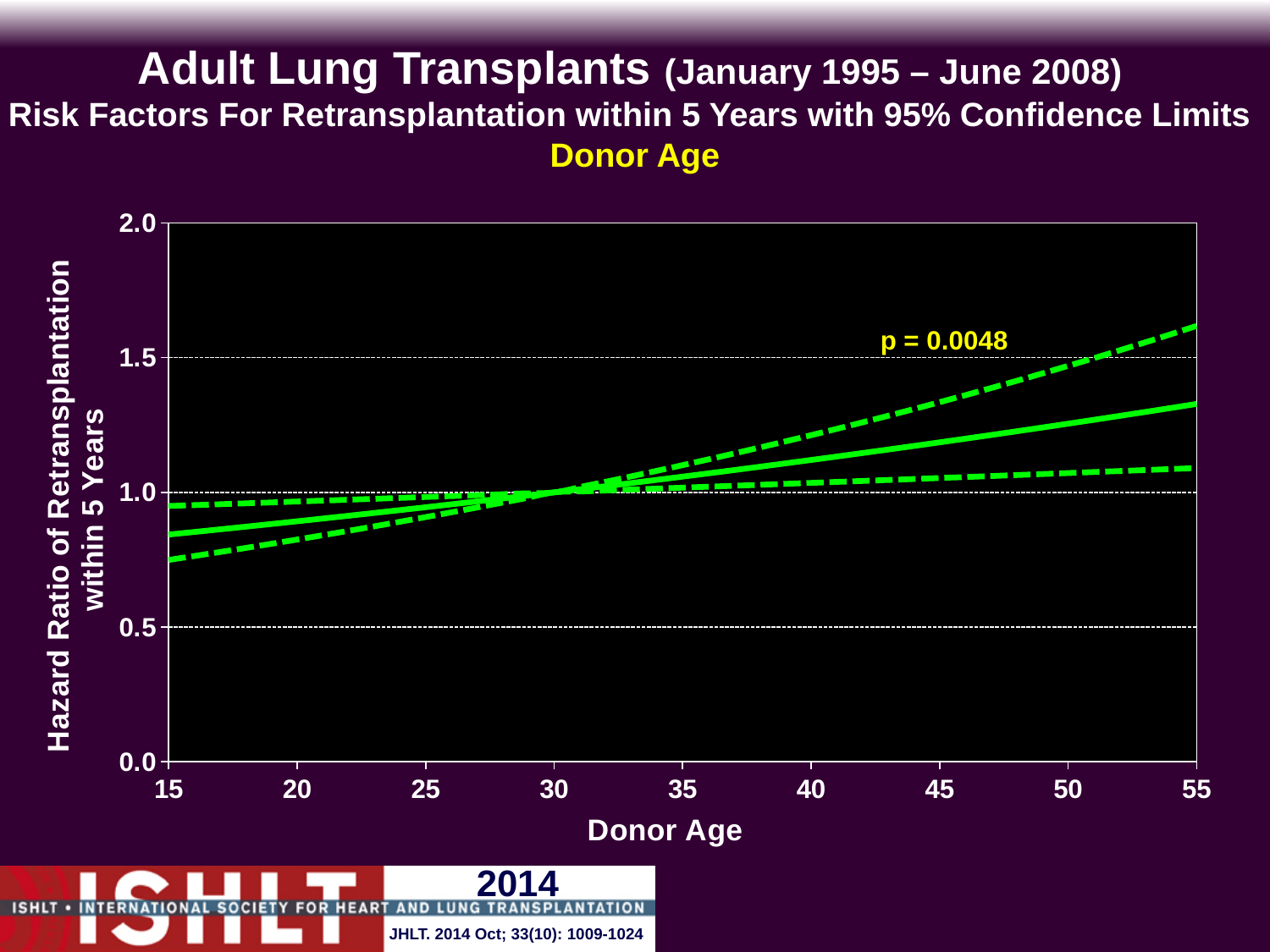
Is the hazard ratio on the solid line at donor age 55 greater or less than 1.5? less What is the label of the x axis? Donor Age Does the hazard ratio of retransplantation within 5 years rise or fall as donor age increases from 15 to 55? rise How many lines are plotted on the chart? 3 What p-value is printed on the chart? p = 0.0048 Is the lower confidence limit (lower dashed line) at donor age 15 greater or less than 0.5? greater Which donor age has the higher hazard ratio on the solid line, 20 or 50? 50 Is the hazard ratio on the solid line at donor age 55 greater or less than 1.0? greater What kind of chart is shown on the slide? line chart